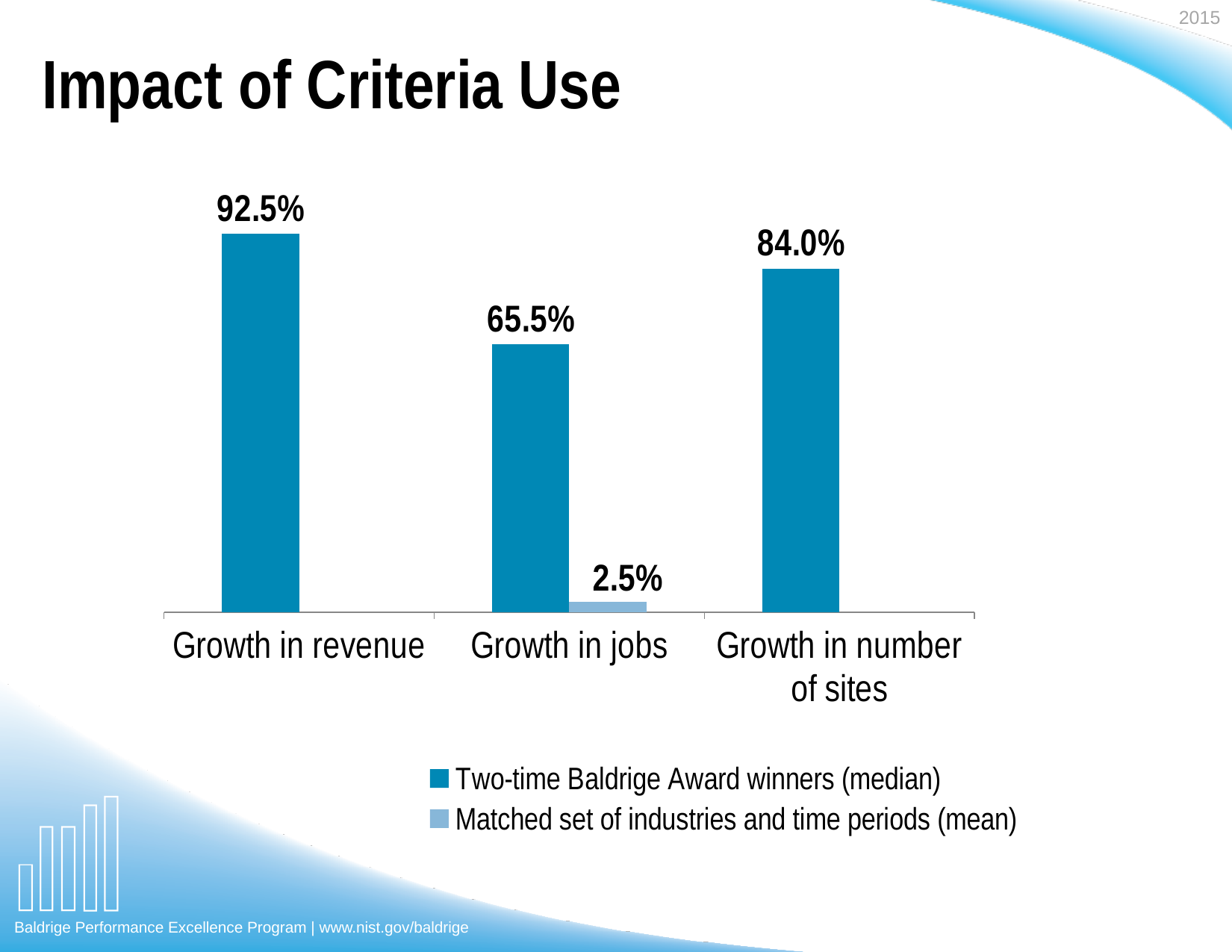
What is the value for Two-time Baldrige Award winners (median) for Growth in jobs? 65.5% What kind of chart is shown on the slide? Bar chart How many series does the chart's legend list? 2 Which category has the highest value for Two-time Baldrige Award winners (median)? Growth in revenue What is the value for Two-time Baldrige Award winners (median) for Growth in number of sites? 84.0% Which category has the lowest value for Two-time Baldrige Award winners (median)? Growth in jobs How many categories are shown on the x axis of the chart? 3 Which is larger for Two-time Baldrige Award winners (median): Growth in number of sites or Growth in jobs? Growth in number of sites For Growth in jobs, what is the difference between the Two-time Baldrige Award winners (median) value and the Matched set of industries and time periods (mean) value? 63.0% What is the value for Matched set of industries and time periods (mean) for Growth in jobs? 2.5% What is the difference between the Two-time Baldrige Award winners (median) values for Growth in revenue and Growth in jobs? 27.0% What is the value for Two-time Baldrige Award winners (median) for Growth in revenue? 92.5%